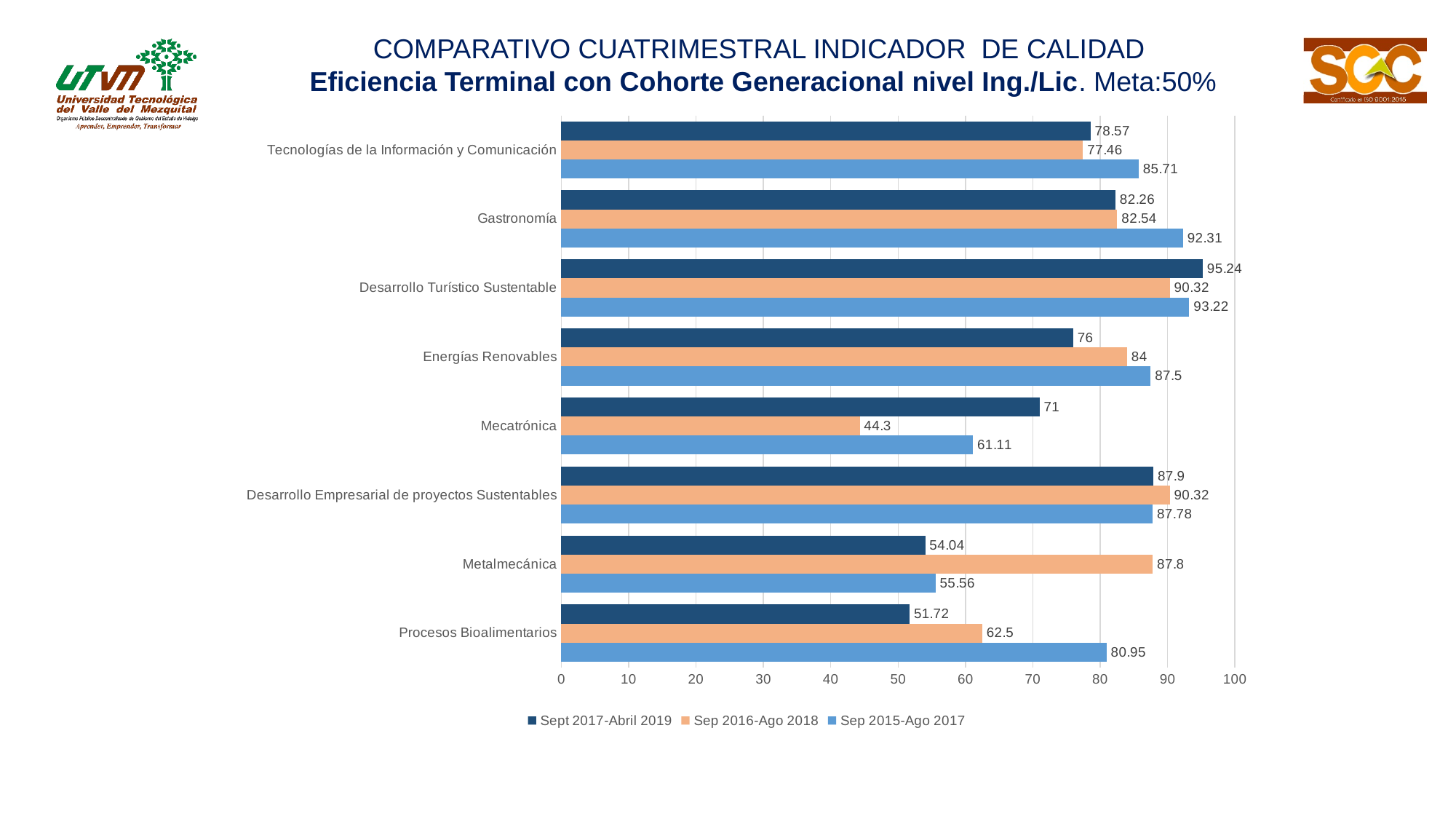
What kind of chart is shown on the slide? Bar chart What is the value for Mecatrónica in the Sep 2016-Ago 2018 series? 44.3 For Procesos Bioalimentarios, what is the difference between the Sep 2015-Ago 2017 value and the Sept 2017-Abril 2019 value? 29.23 Which category has the lowest value in the Sep 2016-Ago 2018 series? Mecatrónica What is the value for Gastronomía in the Sep 2015-Ago 2017 series? 92.31 What is the value for Procesos Bioalimentarios in the Sep 2015-Ago 2017 series? 80.95 How many categories (programs) are shown on the chart? 8 For Metalmecánica, what is the difference between the Sep 2016-Ago 2018 value and the Sept 2017-Abril 2019 value? 33.76 Which category has the highest value in the Sept 2017-Abril 2019 series? Desarrollo Turístico Sustentable How many series does the legend list? 3 Which category has the lowest value in the Sep 2015-Ago 2017 series? Metalmecánica For Energías Renovables, which series has the larger value: Sept 2017-Abril 2019 or Sep 2016-Ago 2018? Sep 2016-Ago 2018